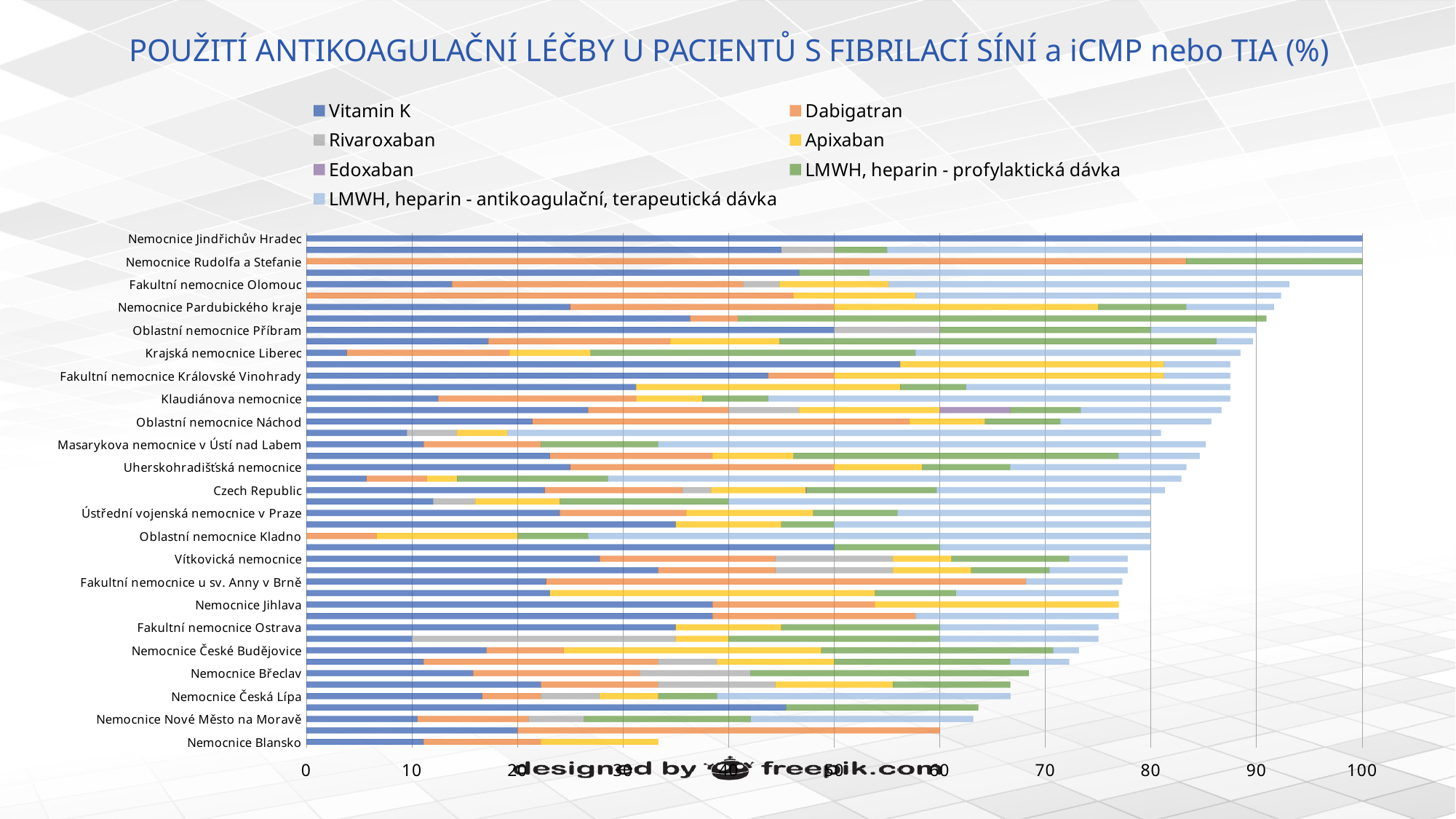
What is the title of the chart? POUŽITÍ ANTIKOAGULAČNÍ LÉČBY U PACIENTŮ S FIBRILACÍ SÍNÍ a iCMP nebo TIA (%) How many series does the legend list? 7 Is the total for Nemocnice Břeclav greater or less than 70? less What is the total length of the bar for Nemocnice Jindřichův Hradec? 100 Which labelled hospital has the shortest bar? Nemocnice Blansko Is the total for Czech Republic greater or less than 90? less Is the total for Nemocnice Blansko greater or less than 40? less Which has the longer bar, Nemocnice Jindřichův Hradec or Nemocnice Blansko? Nemocnice Jindřichův Hradec What kind of chart is shown on the slide? Stacked horizontal bar chart Do the bar totals increase or decrease going from the top of the chart to the bottom? Decrease Which colour represents Dabigatran in the legend? Orange